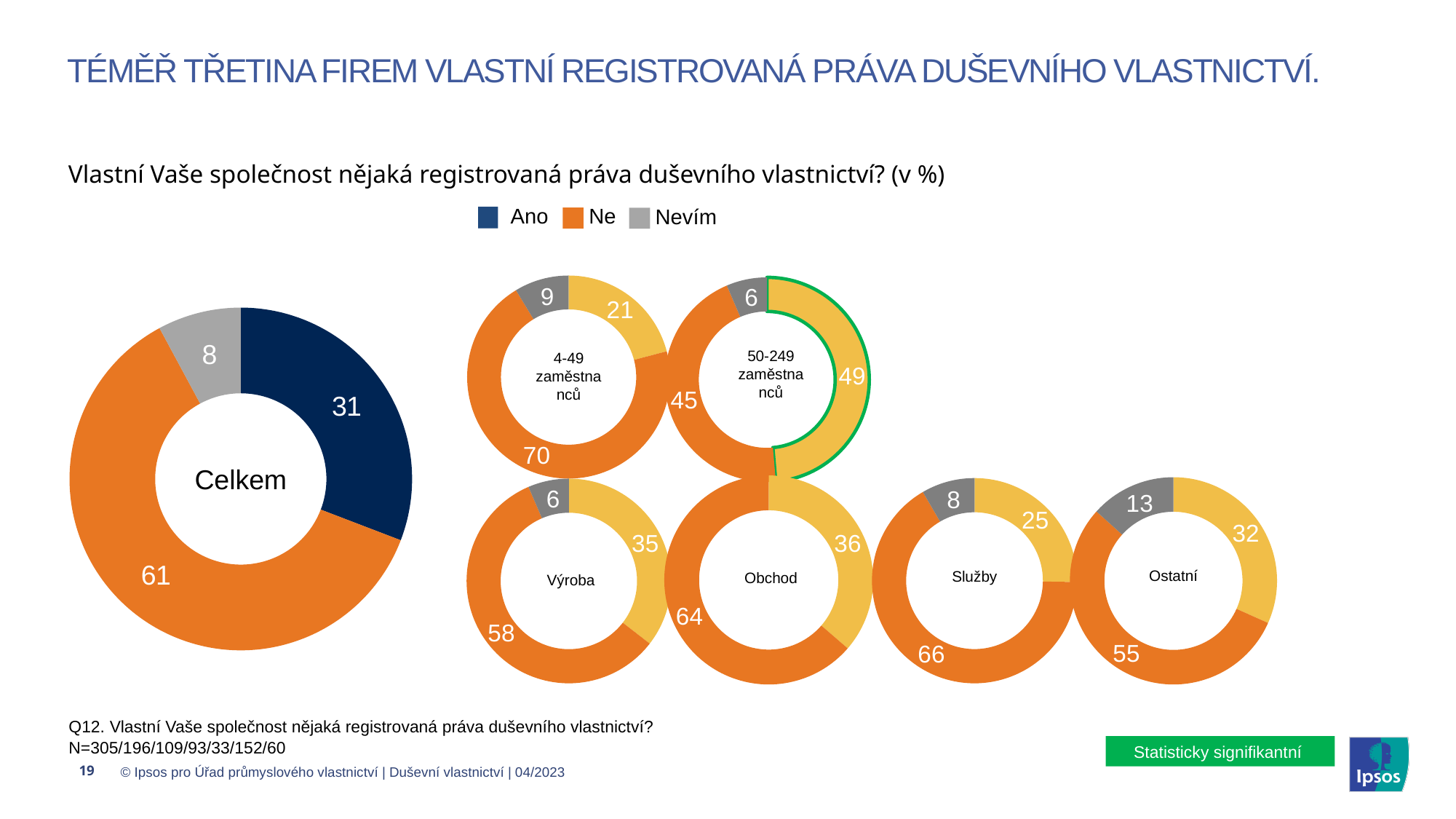
In the Celkem donut chart, what is the value for Nevím? 8 In the 50-249 zaměstnanců donut chart, what is the value of the grey (Nevím) segment? 6 Which is larger: the orange (Ne) segment in the Výroba chart or the orange (Ne) segment in the Obchod chart? Obchod In the Celkem donut chart, what is the value for Ne? 61 What kind of chart is used on this slide? Donut chart In the Celkem donut chart, which category has the largest share? Ne How many series does the legend list? 3 In the Celkem donut chart, what is the difference between the Ne and Ano values? 30 In the Služby donut chart, what is the difference between the orange (Ne) segment and the yellow segment? 41 In the Ostatní donut chart, what is the value of the grey (Nevím) segment? 13 In the Celkem donut chart, what is the value for Ano? 31 In the 4-49 zaměstnanců donut chart, what is the value of the orange (Ne) segment? 70